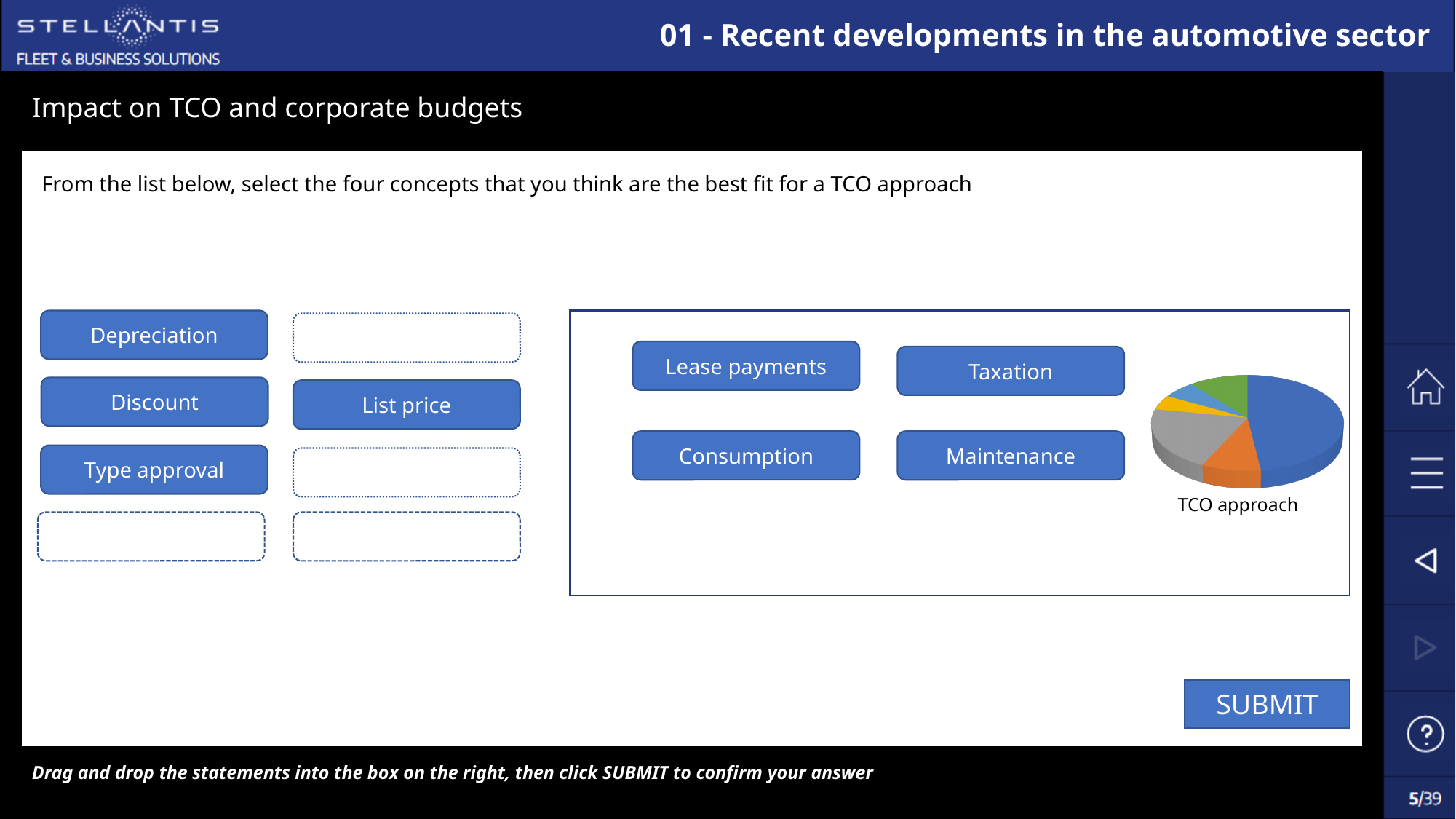
Which is larger in the pie chart, the gray slice or the yellow slice? gray Which is larger in the pie chart, the blue slice or the orange slice? blue What is the title of the pie chart on the slide? TCO approach Which colour slice is the largest in the pie chart? blue What kind of chart is shown on the slide? pie chart Does the pie chart display a legend? No How many slices does the pie chart have? 6